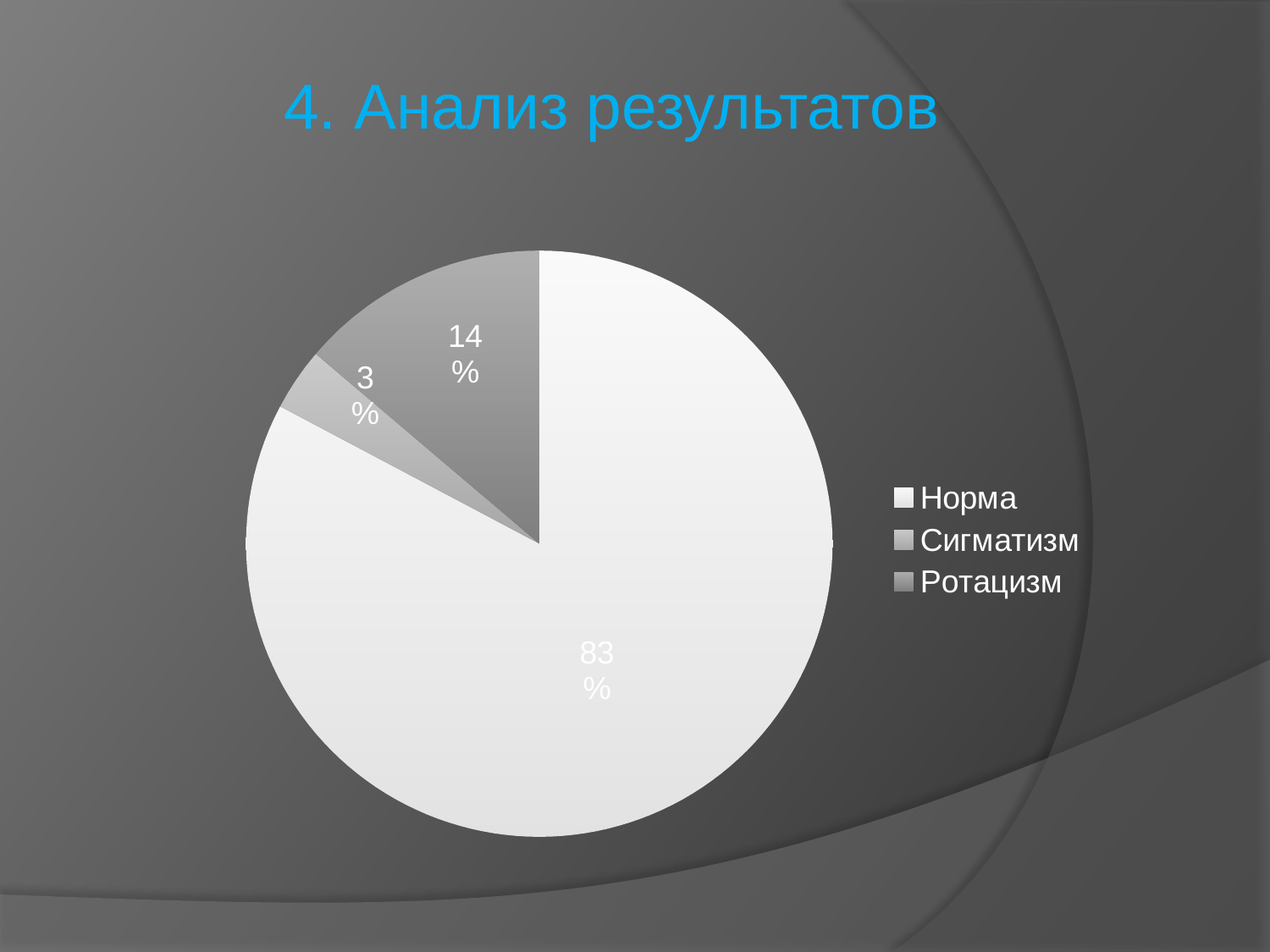
What is the title of the slide containing the pie chart? 4. Анализ результатов Which category has the smallest slice of the pie chart? Сигматизм What kind of chart is shown on the slide? pie chart How many slices does the pie chart have? 3 What is the difference in percentage points between Норма and Ротацизм? 69 Which is larger, the share for Ротацизм or the share for Сигматизм? Ротацизм Which category has the largest slice of the pie chart? Норма How many entries does the legend list? 3 What is the share for Сигматизм in the pie chart? 3% What is the difference in percentage points between Ротацизм and Сигматизм? 11 What is the share for Норма in the pie chart? 83% What is the share for Ротацизм in the pie chart? 14%